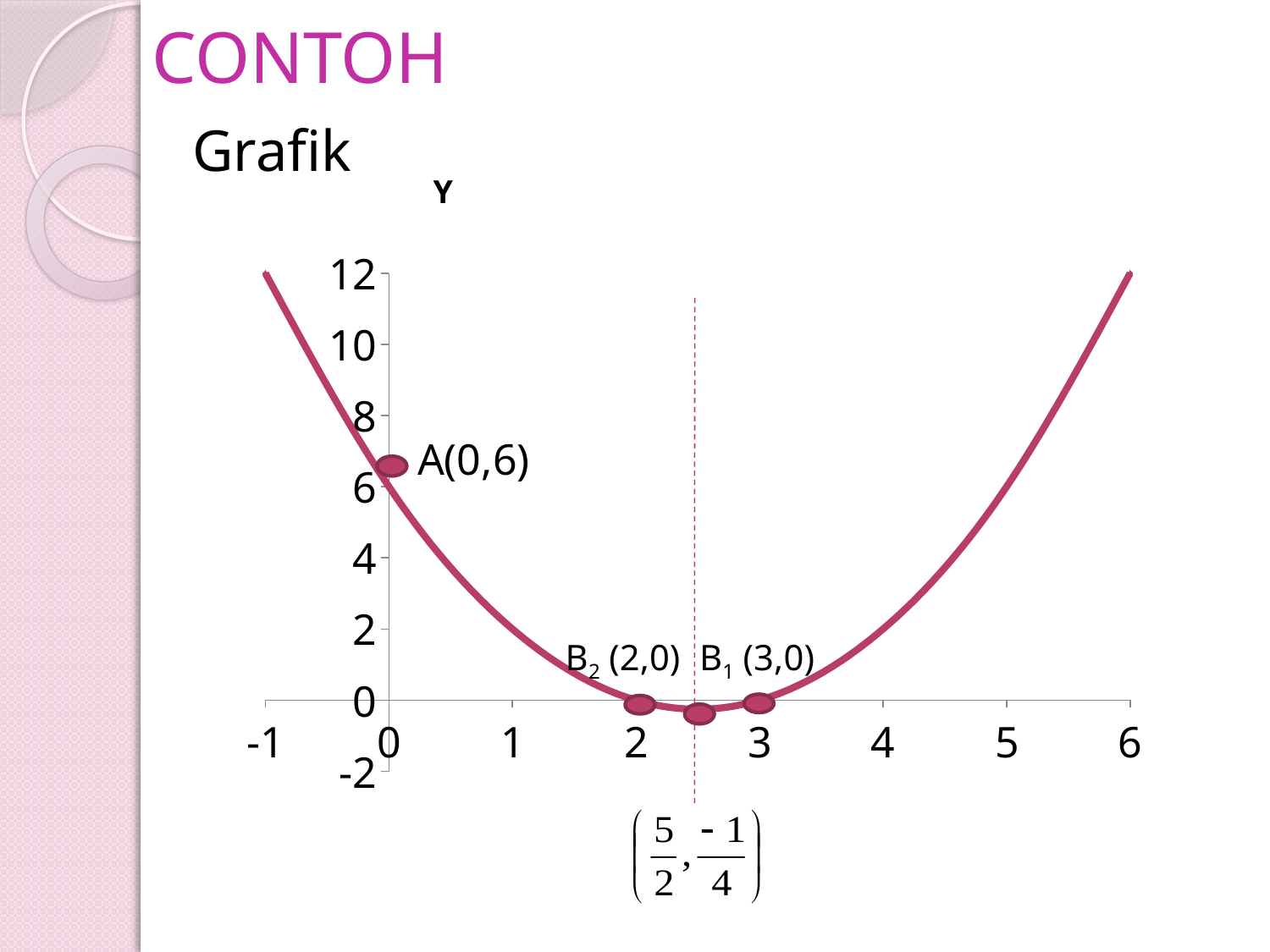
What are the coordinates of point B2? (2,0) At which two x values does the curve cross the x axis? 2 and 3 Which point has the higher y value, A or B1? A What are the coordinates of point B1? (3,0) Does the curve rise or fall as x increases from 3 to 6? rise Is the value of the curve at x = 5 greater or less than 4? greater What is the highest value shown on the y axis? 12 How many points are marked with dots on the curve? 4 What are the coordinates of the lowest point (vertex) of the curve, as labelled below the graph? (5/2, -1/4) At what x value is the vertical dashed line drawn? 5/2 What are the coordinates of point A on the graph? (0,6) What kind of chart is shown on the slide? line chart